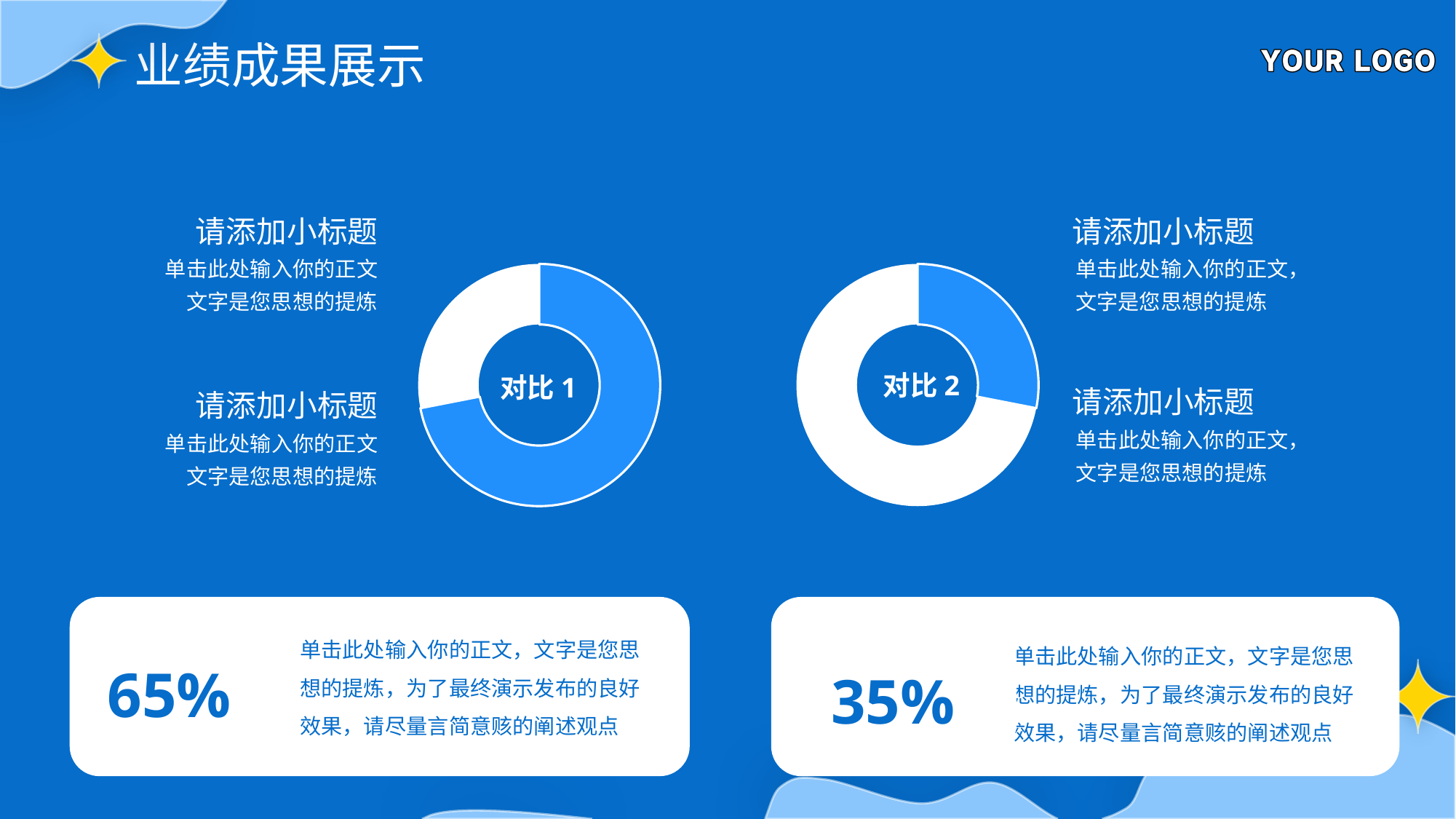
Which chart has the larger blue slice, 对比 1 or 对比 2? 对比 1 In the 对比 2 chart, is the blue slice's share greater or less than 50%? less How many donut charts are shown on the slide? 2 How many slices does the 对比 1 donut chart have? 2 What label is printed in the centre of the left donut chart? 对比 1 In the 对比 1 chart, which slice is larger, the blue one or the white one? The blue one What kind of chart is the chart labelled 对比 1? Donut chart How many slices does the 对比 2 donut chart have? 2 What percentage figure is printed in the box beneath the 对比 2 chart? 35% In the 对比 1 chart, is the blue slice's share greater or less than 50%? greater In the 对比 2 chart, which slice is larger, the blue one or the white one? The white one